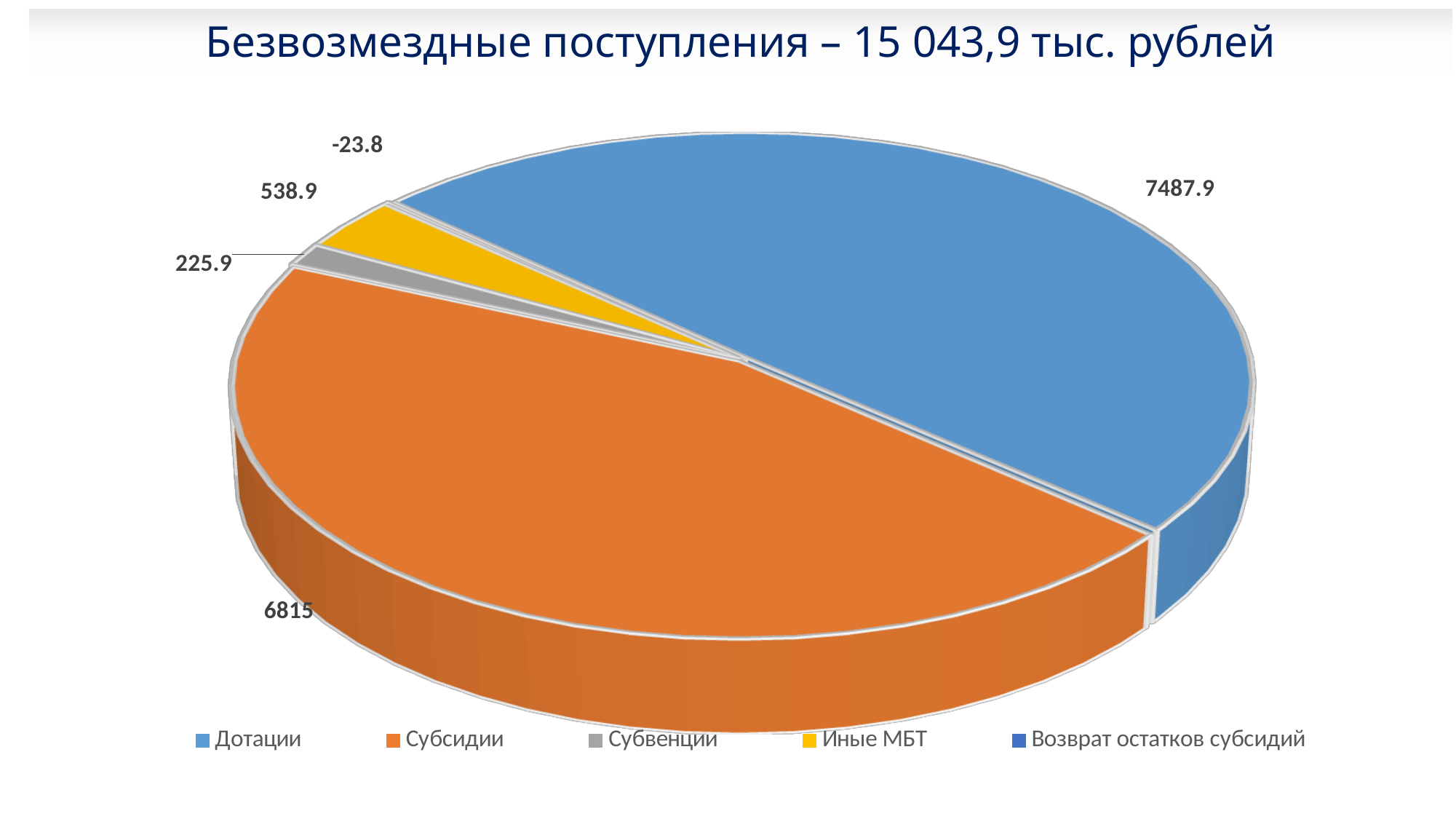
What is the title of the chart? Безвозмездные поступления – 15 043,9 тыс. рублей What is the difference between the values for Дотации and Субсидии? 672.9 What is the value for Субсидии? 6815 What is the value for Иные МБТ? 538.9 What is the value for Дотации? 7487.9 Which category has the highest value? Дотации Which category has the lowest value? Возврат остатков субсидий What type of chart is shown on the slide? pie chart Which is larger, the value for Иные МБТ or the value for Субвенции? Иные МБТ What is the value for Возврат остатков субсидий? -23.8 What is the value for Субвенции? 225.9 How many categories does the legend list? 5